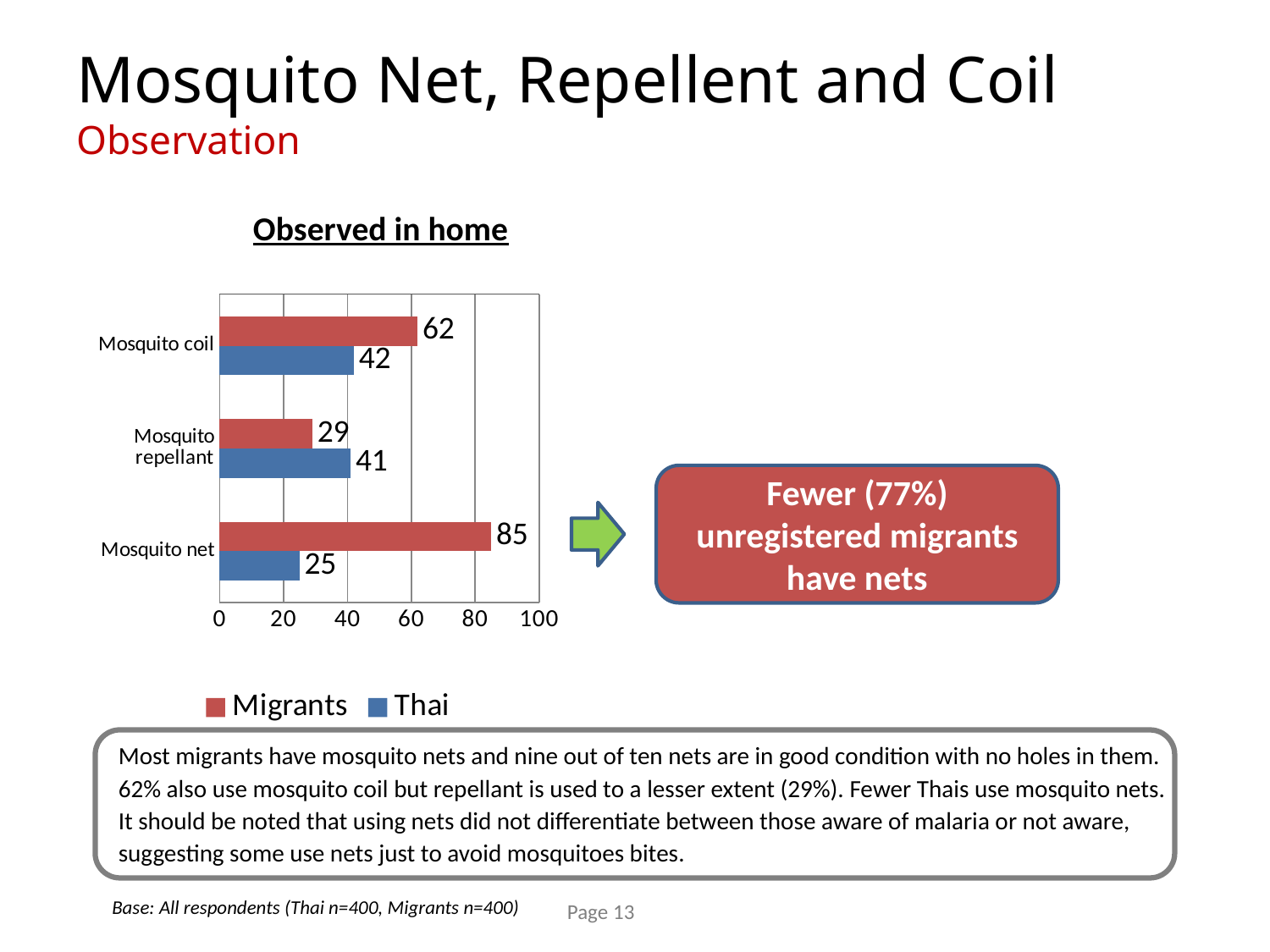
How many series does the legend list? 2 Is the Migrants value for Mosquito coil greater or less than 40? greater What kind of chart is shown on the slide? bar chart Which is larger for Mosquito repellant, the Migrants value or the Thai value? Thai What is the title of the chart? Observed in home What is the value for Migrants for Mosquito repellant? 29 What is the value for Migrants for Mosquito net? 85 Which category has the lowest value for Thai? Mosquito net What is the difference between the Migrants and Thai values for Mosquito net? 60 How many categories are shown on the chart? 3 What is the value for Thai for Mosquito coil? 42 Which category has the highest value for Migrants? Mosquito net